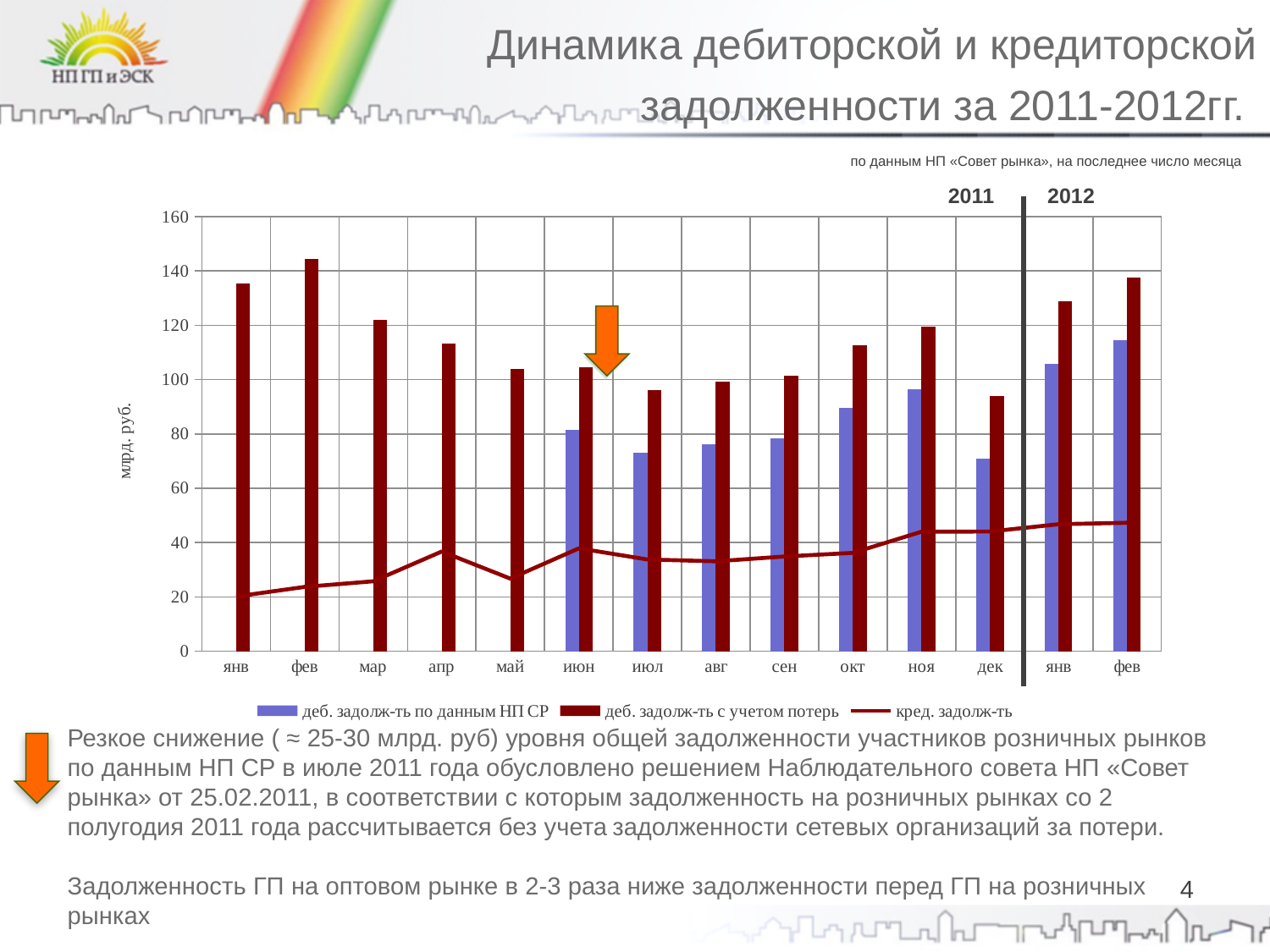
What is the label of the vertical axis? млрд. руб. What kind of chart is shown on the slide? A combined bar and line chart Is the value of 'деб. задолж-ть с учетом потерь' for дек 2011 greater or less than 100? less Which is larger in апр 2011 or май 2011 for 'деб. задолж-ть с учетом потерь'? апр 2011 Is the value of 'кред. задолж-ть' for янв 2011 greater or less than 40? less How many series does the chart legend list? 3 In which month is the 'деб. задолж-ть по данным НП СР' bar highest? фев 2012 Is the value of 'деб. задолж-ть по данным НП СР' for фев 2012 greater or less than 100? greater Which series is drawn as a line rather than bars? кред. задолж-ть In which month is the 'кред. задолж-ть' line at its lowest? янв 2011 How many months (categories) are shown along the x axis? 14